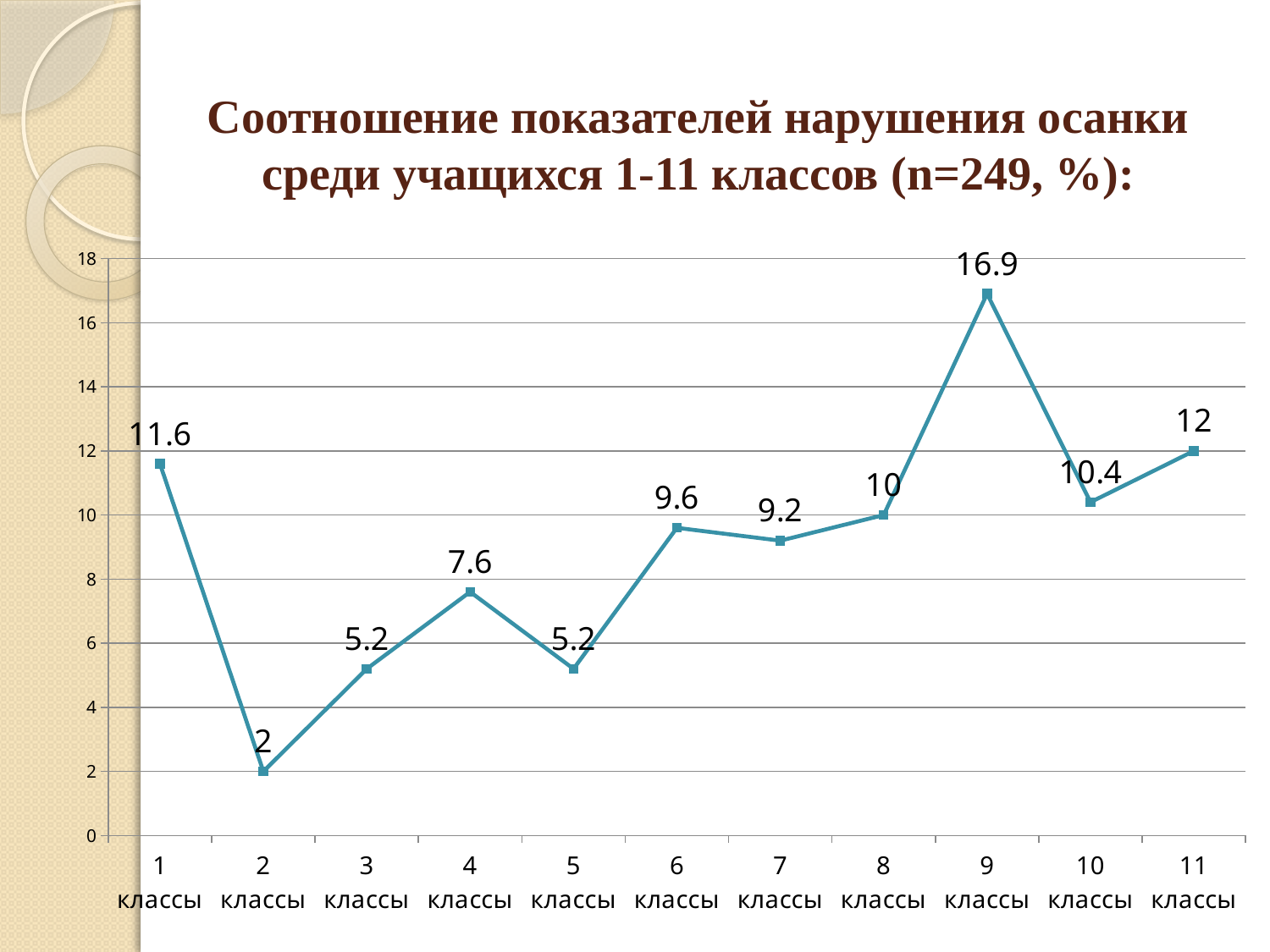
Which class has the highest value? 9 классы Which class has the lowest value? 2 классы What kind of chart is shown? line chart Is the value for 4 классы greater or less than 8? less What is the value for 2 классы? 2 What is the value for 1 классы? 11.6 Which is larger, the value for 6 классы or 7 классы? 6 классы Do the values rise or fall from 2 классы to 4 классы? rise What is the value for 9 классы? 16.9 What is the value for 11 классы? 12 How many classes are plotted on the chart? 11 What is the difference between the values for 9 классы and 10 классы? 6.5